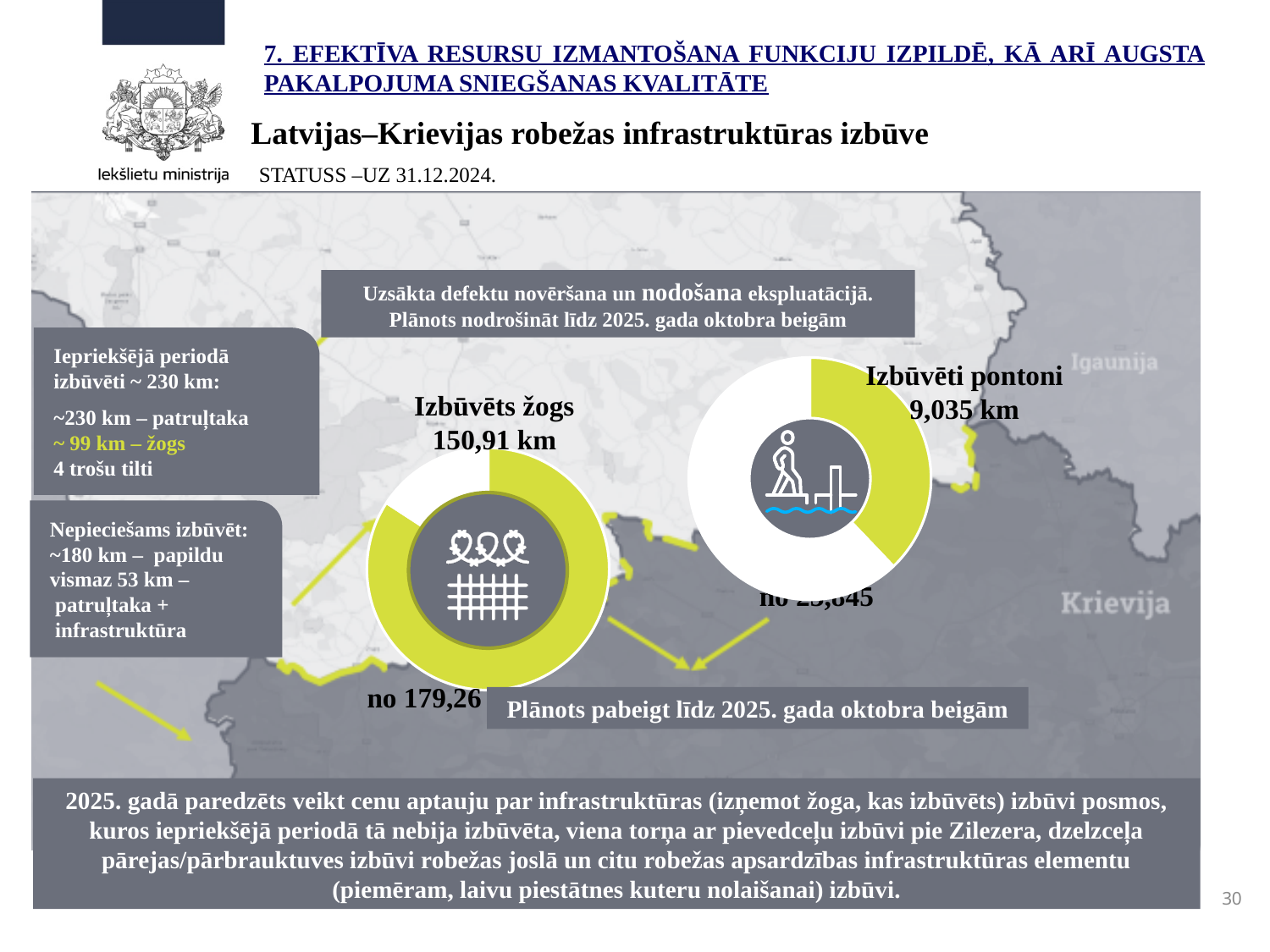
In the 'Izbūvēts žogs' chart, how many kilometres of fence remain to reach the total of 179,26? 28,35 What colour is used for the completed portion in both donut charts? yellow-green What is the title of the left donut chart? Izbūvēts žogs In the 'Izbūvēts žogs' chart, what is the total length the built fence is measured against (the 'no' value)? 179,26 Which built length is larger: the fence in the 'Izbūvēts žogs' chart or the pontoons in the 'Izbūvēti pontoni' chart? Izbūvēts žogs In the 'Izbūvēts žogs' chart, how many kilometres of fence have been built? 150,91 km How many donut charts are shown on the slide? 2 In the 'Izbūvēti pontoni' chart, how many kilometres of pontoons have been built? 9,035 km What kind of chart is used to show the built fence (Izbūvēts žogs) on the slide? donut chart